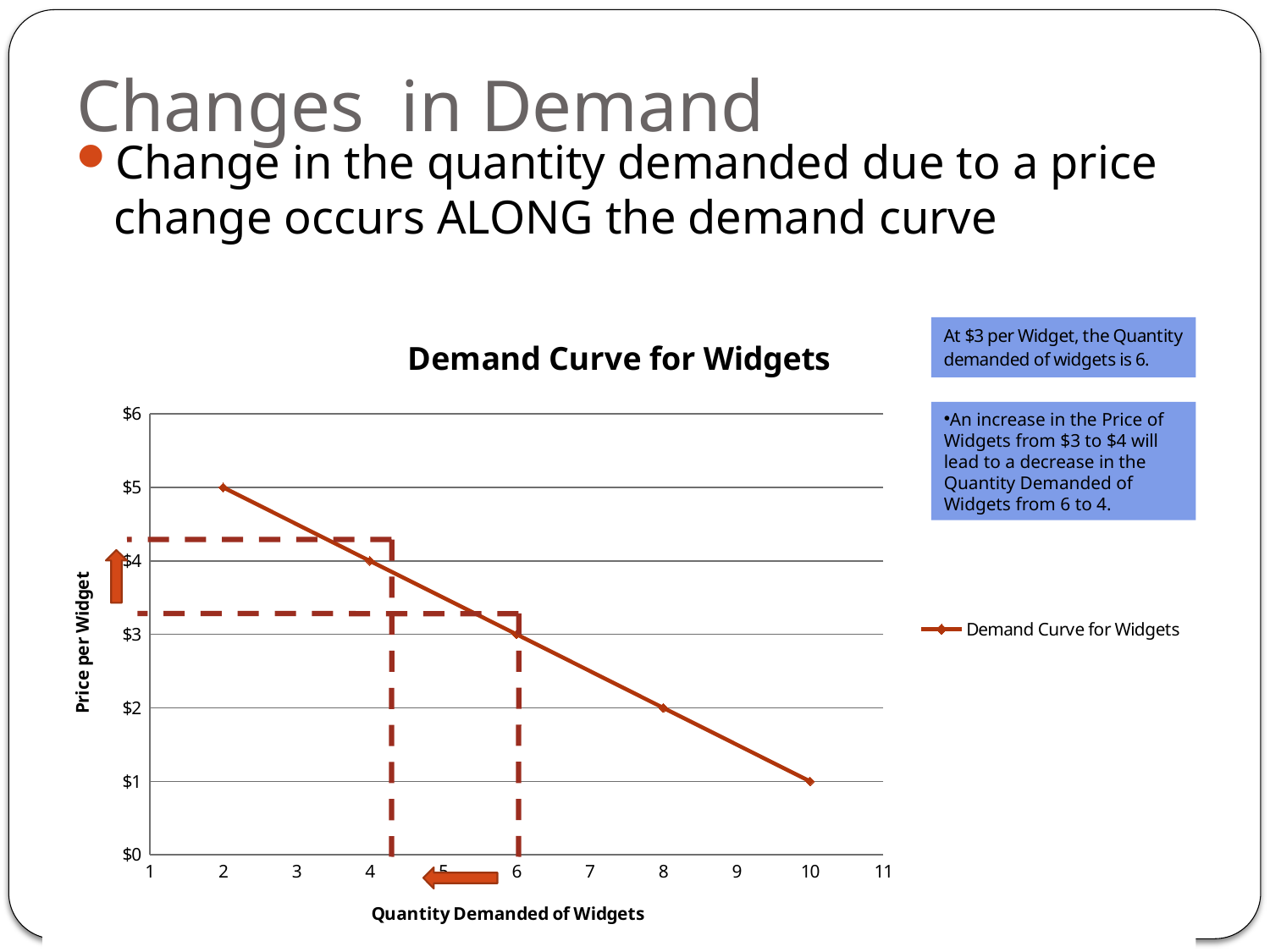
Does the price per widget rise or fall as the quantity demanded increases along the x axis? fall What is the title of the chart? Demand Curve for Widgets What is the quantity demanded of widgets at a price of $1? 10 What is the price per widget when the quantity demanded is 6? $3 What is the quantity demanded of widgets at a price of $5? 2 What is the difference in price per widget between a quantity demanded of 4 and a quantity demanded of 6? $1 How many series does the chart legend list? 1 What type of chart is shown on the slide? line chart How many data points are plotted on the demand curve? 5 At which quantity demanded is the price per widget highest? 2 What is the price per widget when the quantity demanded is 4? $4 At which quantity demanded is the price per widget lowest? 10